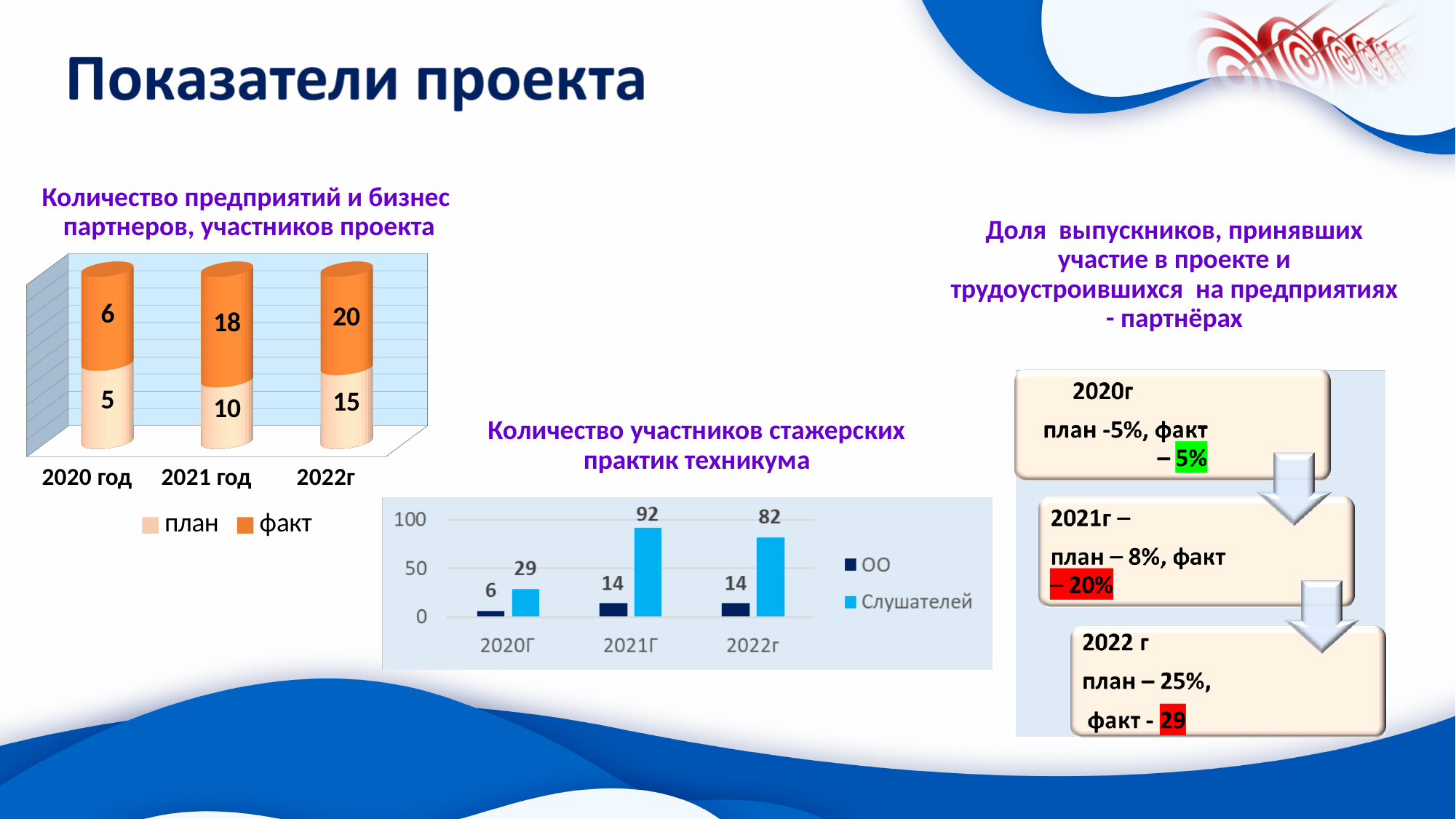
In the chart 'Количество предприятий и бизнес партнеров, участников проекта', what is the total of the stacked bar for 2020 год? 11 In the chart 'Количество предприятий и бизнес партнеров, участников проекта', how many series does the legend list? 2 In the chart 'Количество предприятий и бизнес партнеров, участников проекта', what is the факт value for 2021 год? 18 In the chart 'Количество участников стажерских практик техникума', what is the difference between the Слушателей values for 2021Г and 2022г? 10 In the chart 'Количество участников стажерских практик техникума', which year has the lowest Слушателей value? 2020Г In the chart 'Количество предприятий и бизнес партнеров, участников проекта', what is the план value for 2022г? 15 In the chart 'Количество участников стажерских практик техникума', how many categories are shown on the x axis? 3 In the chart 'Количество предприятий и бизнес партнеров, участников проекта', does the факт value rise or fall from 2020 год to 2022г? rise In the chart 'Количество предприятий и бизнес партнеров, участников проекта', which year has the highest факт value? 2022г In the chart 'Количество участников стажерских практик техникума', what is the ОО value for 2020Г? 6 In the chart 'Количество участников стажерских практик техникума', what is the Слушателей value for 2021Г? 92 What kind of chart is 'Количество участников стажерских практик техникума'? bar chart